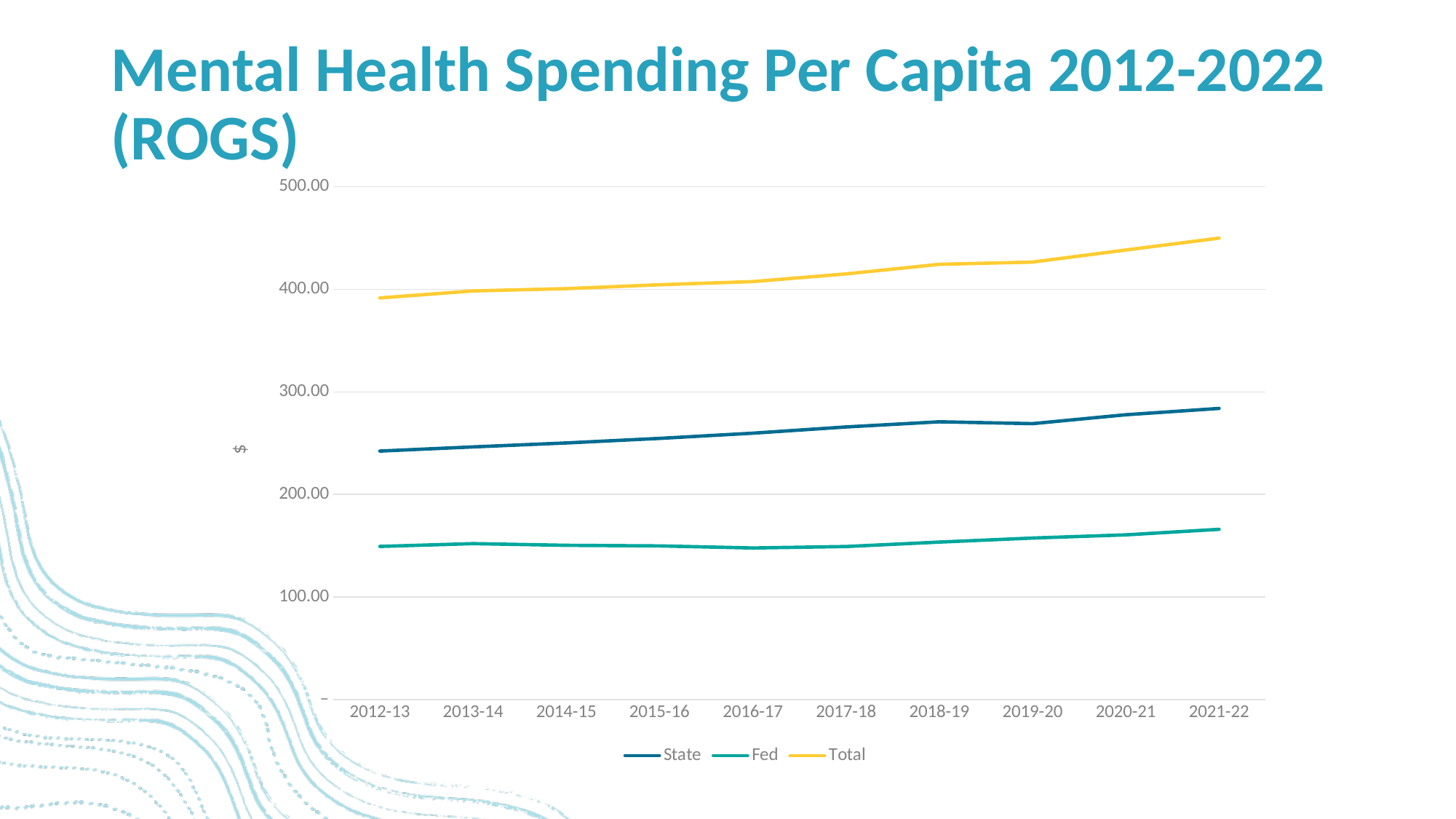
How many financial years are plotted along the x axis? 10 How many series does the legend list? 3 Is the value for Fed in 2012-13 greater or less than 100? greater Which series has the lowest values across all years? Fed Does the Total series rise or fall from 2012-13 to 2021-22? Rises What is the label on the y axis? $ What kind of chart is shown on the slide? Line chart In which year is the Total series at its highest? 2021-22 Which series has the highest values across all years? Total Is the value for Total in 2021-22 greater or less than 400? greater In which year is the Total series at its lowest? 2012-13 Is the value for State in 2021-22 greater or less than 300? less